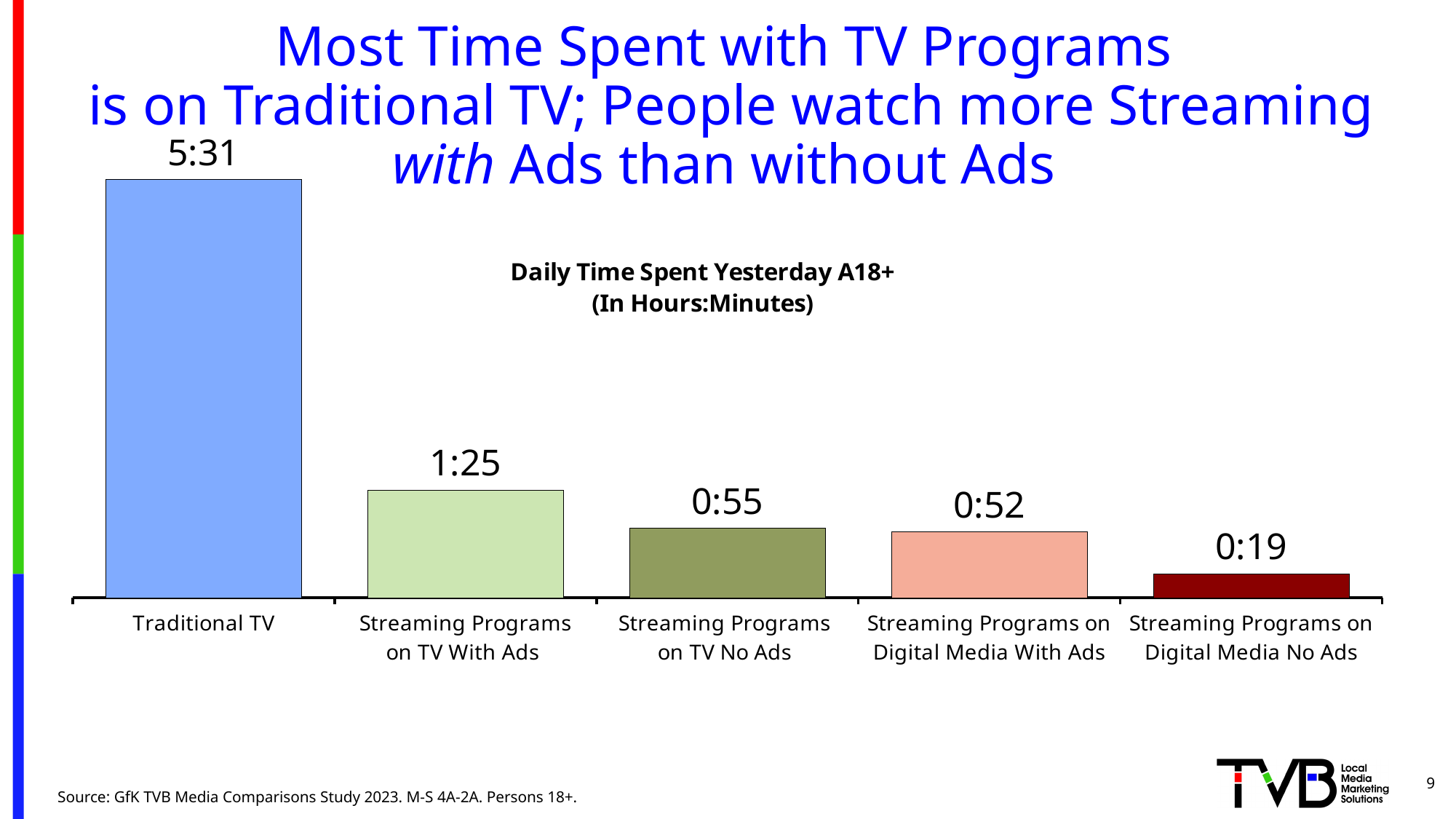
What type of chart is shown on the slide? Bar chart What is the daily time spent on Streaming Programs on TV No Ads? 0:55 How many categories are shown in the chart? 5 What is the title of the chart? Daily Time Spent Yesterday A18+ (In Hours:Minutes) What is the difference in daily time spent between Streaming Programs on Digital Media With Ads and Streaming Programs on Digital Media No Ads? 0:33 Which category has the lowest daily time spent? Streaming Programs on Digital Media No Ads Which category has the highest daily time spent? Traditional TV What is the daily time spent on Traditional TV? 5:31 What is the daily time spent on Streaming Programs on Digital Media No Ads? 0:19 What is the daily time spent on Streaming Programs on TV With Ads? 1:25 Which has more daily time spent: Streaming Programs on TV With Ads or Streaming Programs on TV No Ads? Streaming Programs on TV With Ads How much more daily time is spent on Traditional TV than on Streaming Programs on TV With Ads? 4:06